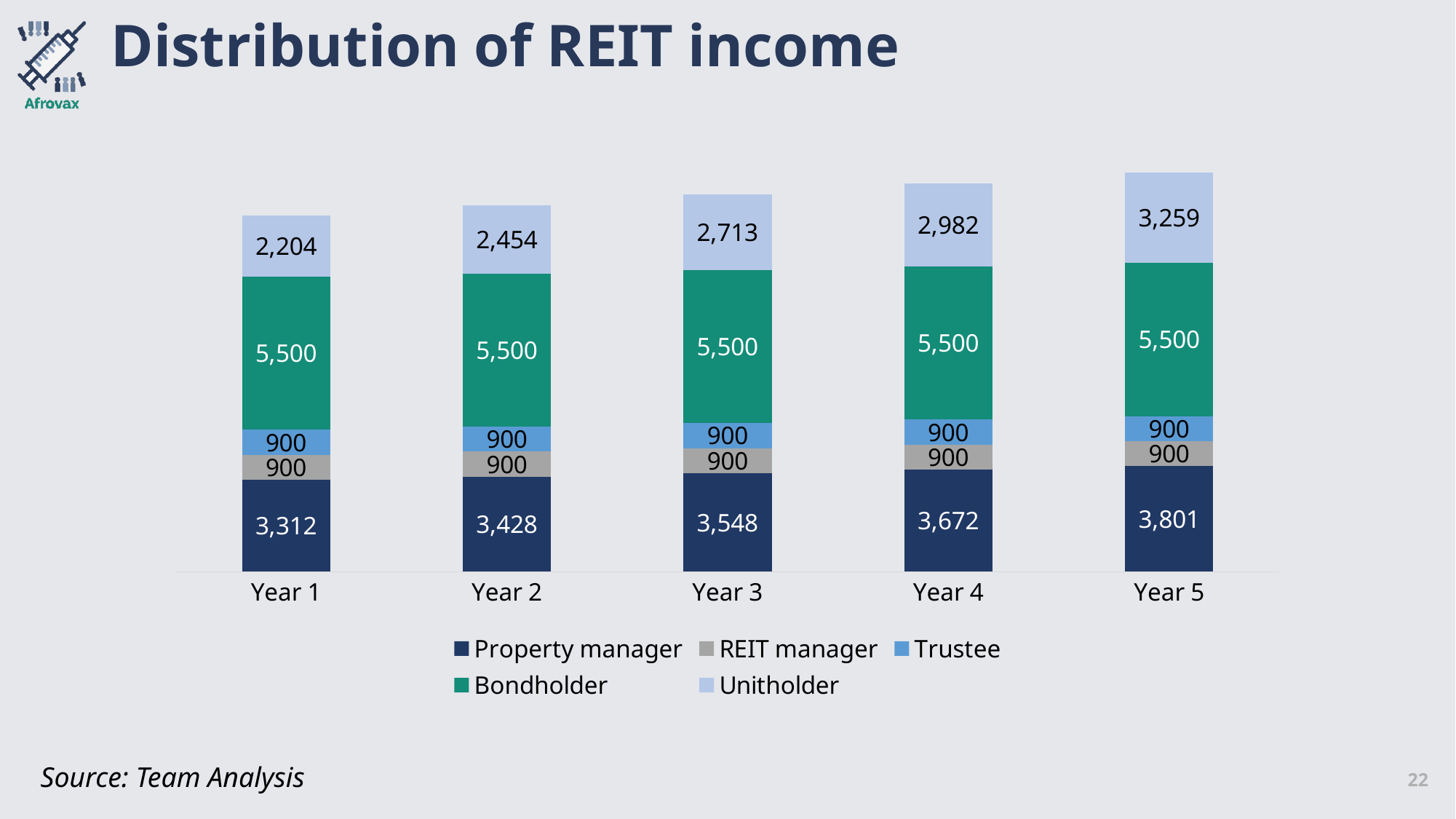
What is the Unitholder value for Year 5? 3,259 What is the total of the stacked bar for Year 1? 12,816 Which is larger, the Property manager value for Year 4 or for Year 2? Year 4 In which year is the Unitholder value highest? Year 5 What is the Trustee value for Year 4? 900 What kind of chart is shown on the slide? Stacked bar chart How many series does the legend list? 5 What is the Bondholder value for Year 2? 5,500 What is the difference between the Unitholder values for Year 5 and Year 1? 1,055 What is the Property manager value for Year 3? 3,548 In which year is the Property manager value lowest? Year 1 How many years are shown on the x axis? 5